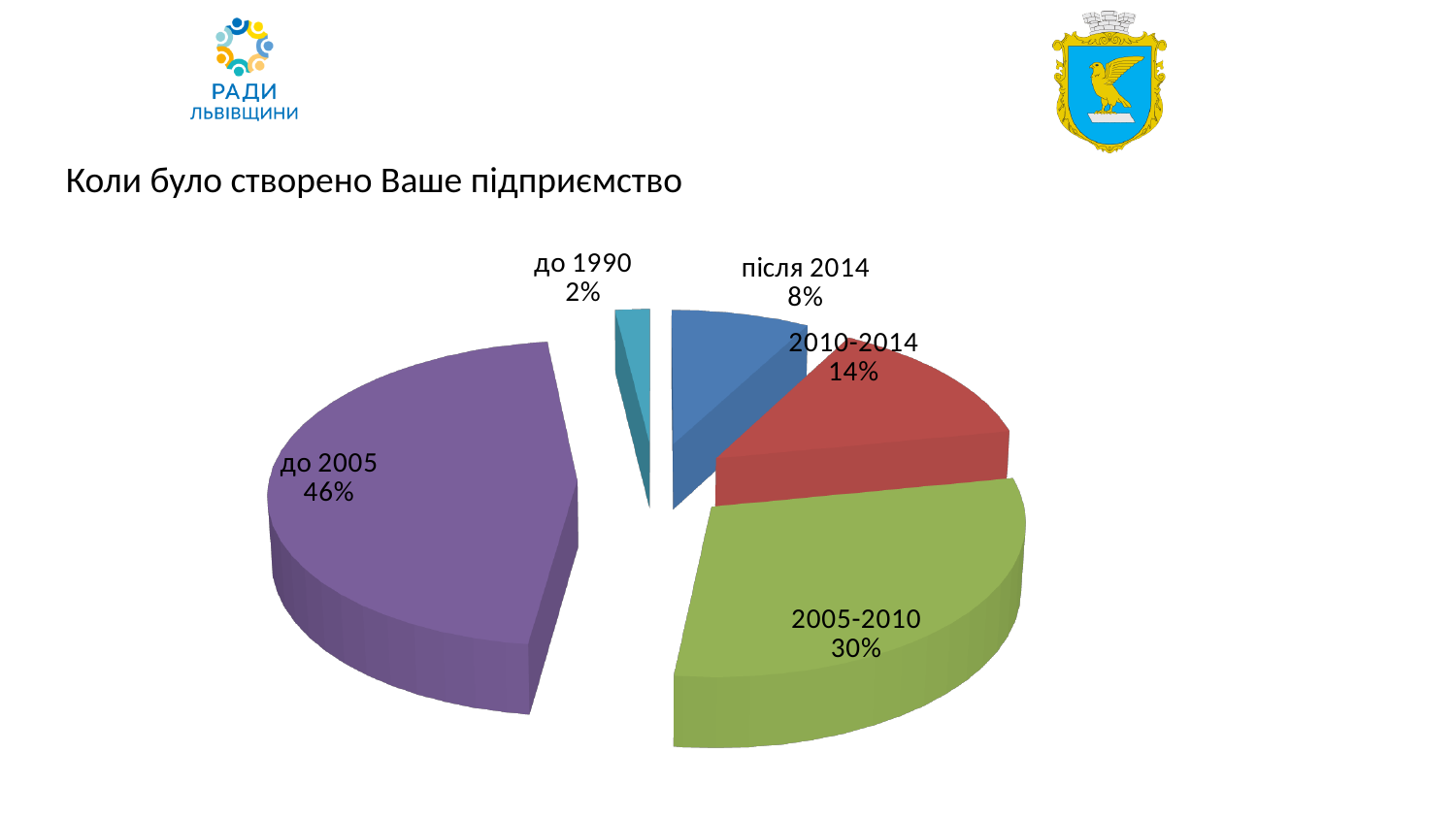
Which is larger, the slice for "2010-2014" or the slice for "після 2014"? 2010-2014 What is the value shown for "до 1990"? 2% What is the title of the chart on the slide? Коли було створено Ваше підприємство What kind of chart is shown on the slide? pie chart Which category has the smallest slice of the pie? до 1990 What is the difference in percentage points between "до 2005" and "2005-2010"? 16 What is the value shown for "після 2014"? 8% What is the value shown for "2010-2014"? 14% What share of the pie does the slice "до 2005" have? 46% How many slices does the pie chart have? 5 What is the value shown for "2005-2010"? 30% Which category has the largest slice of the pie? до 2005